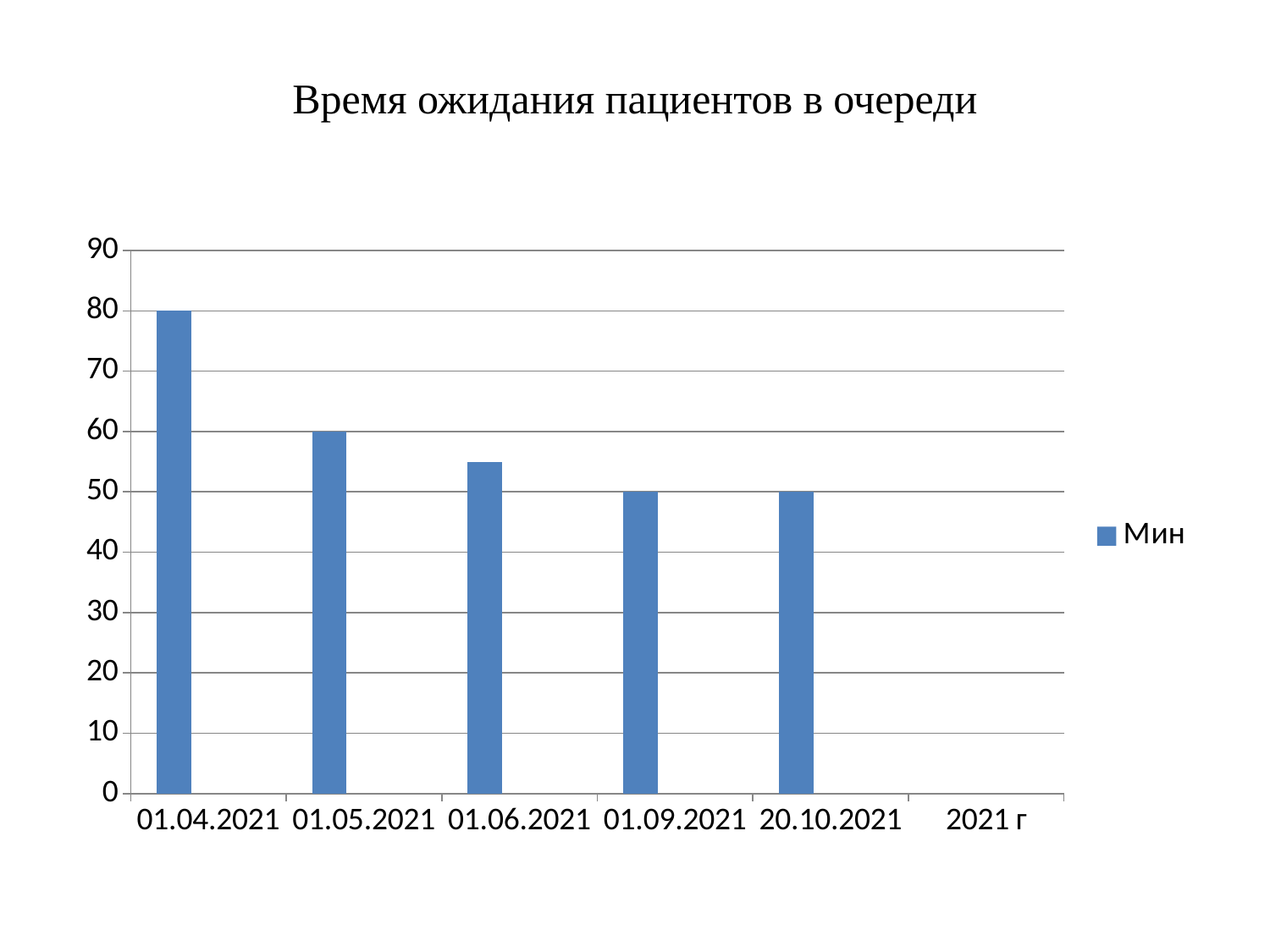
Is the value for 01.06.2021 greater or less than 60? less What is the value for 01.09.2021? 50 What is the value for 01.04.2021? 80 What is the title of the chart? Время ожидания пациентов в очереди What is the name of the series in the legend? Мин Which is larger, the value for 01.05.2021 or the value for 20.10.2021? 01.05.2021 What is the difference between the values for 01.04.2021 and 01.05.2021? 20 Do the values rise or fall from 01.04.2021 to 20.10.2021? fall How many series does the legend list? 1 What type of chart is shown on the slide? bar chart Which date has the highest value? 01.04.2021 What is the value for 01.05.2021? 60